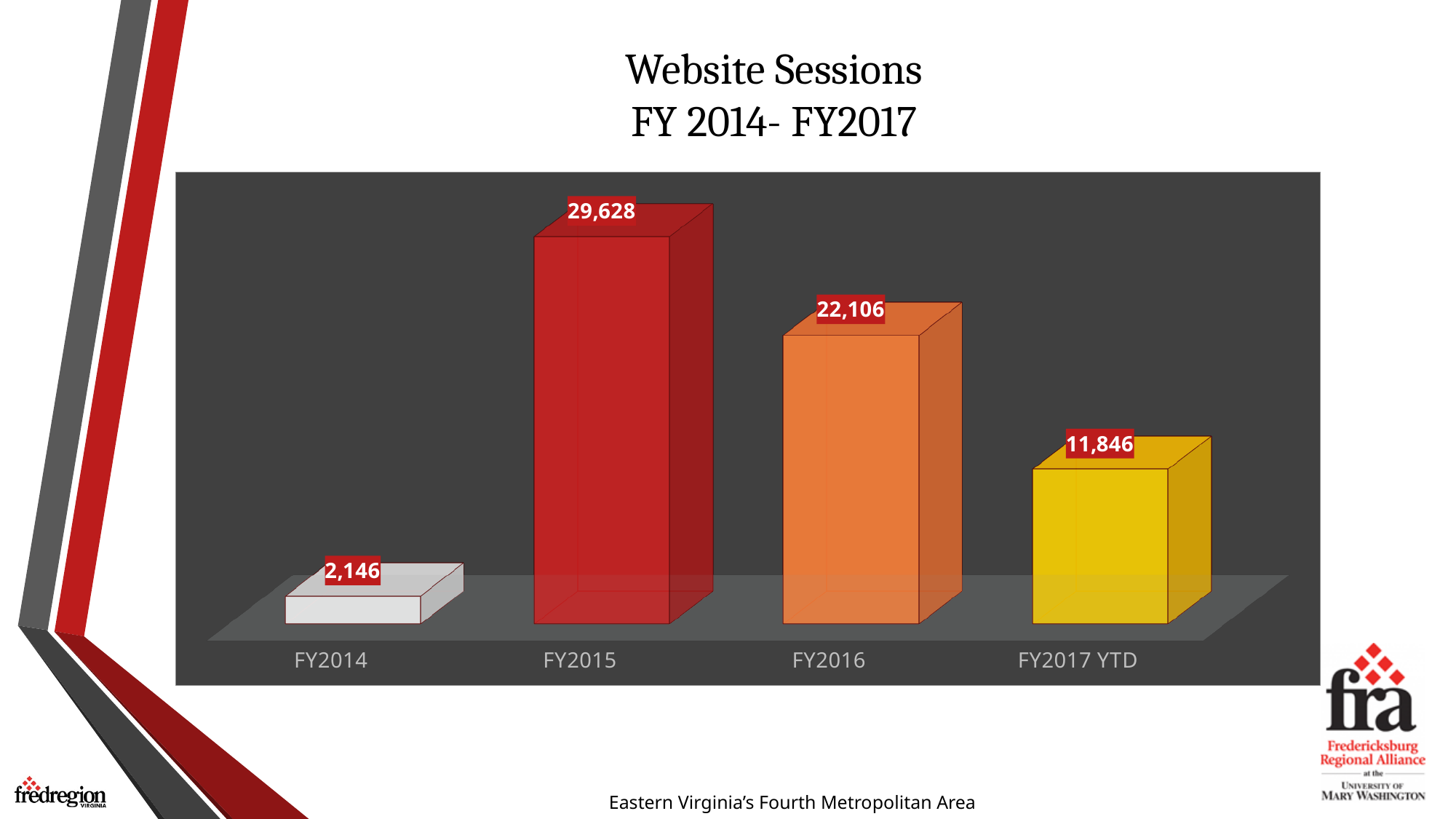
How many fiscal year categories are shown in the chart? 4 What is the difference in website sessions between FY2015 and FY2016? 7,522 Which has more website sessions, FY2016 or FY2017 YTD? FY2016 Do website sessions rise or fall from FY2015 to FY2017 YTD? Fall What is the title of the chart? Website Sessions FY 2014- FY2017 What type of chart is shown on the slide? Bar chart Which fiscal year has the lowest number of website sessions? FY2014 Which fiscal year has the highest number of website sessions? FY2015 What is the number of website sessions for FY2015? 29,628 What is the number of website sessions for FY2017 YTD? 11,846 What is the number of website sessions for FY2014? 2,146 What is the difference in website sessions between FY2016 and FY2017 YTD? 10,260